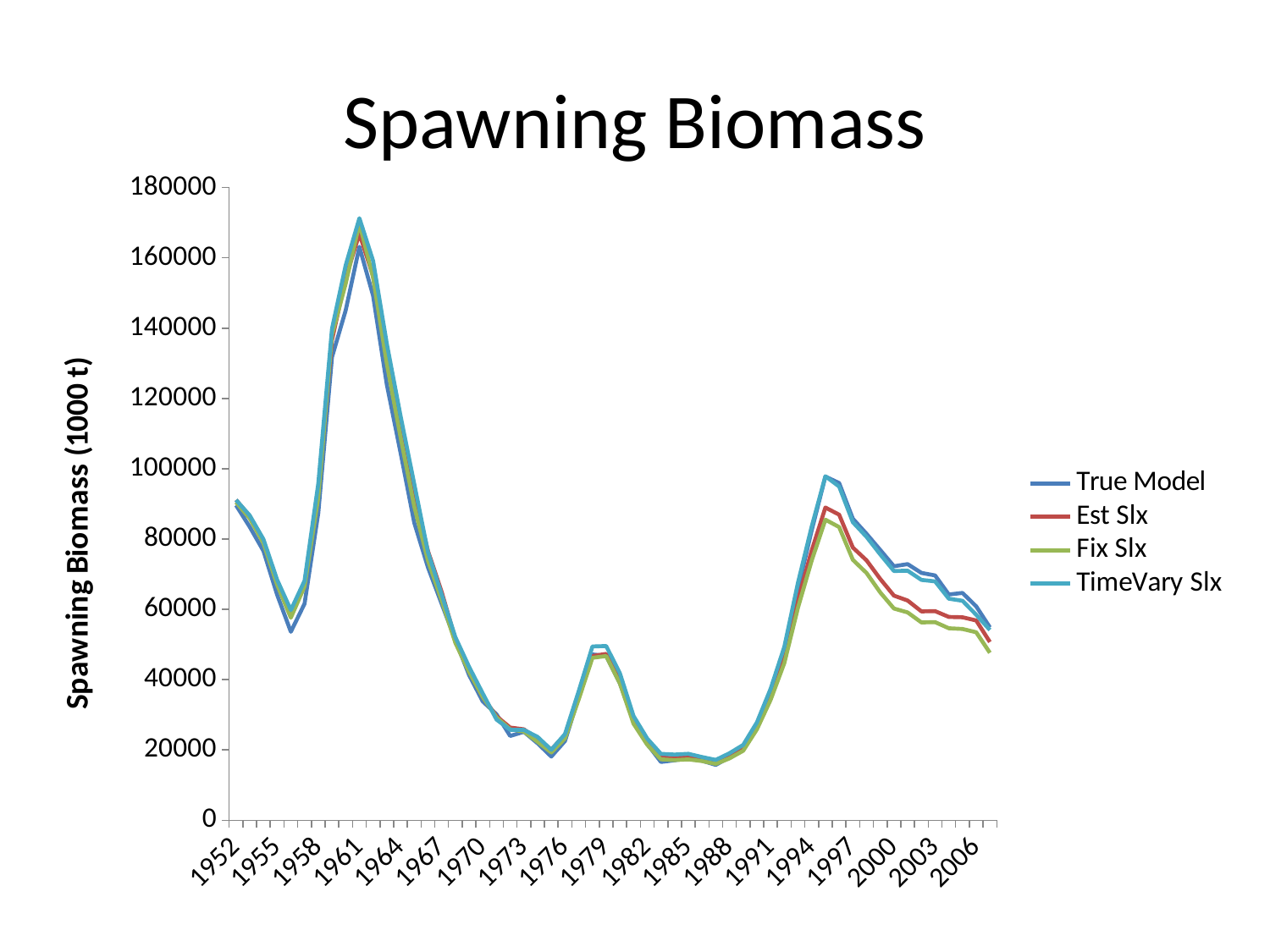
Do the values rise or fall from 1997 to 2006? fall Is the value for True Model in 1976 greater or less than 40000? less What is the title of the chart? Spawning Biomass Which series has the lowest value in 2003? Fix Slx Is the value for TimeVary Slx in 1979 greater or less than 40000? greater What kind of chart is shown on the slide? line chart Is the value for True Model in 1952 greater or less than 80000? greater In 2000, which is larger, the value for TimeVary Slx or the value for Fix Slx? TimeVary Slx What is the label on the vertical axis? Spawning Biomass (1000 t) How many series does the legend list? 4